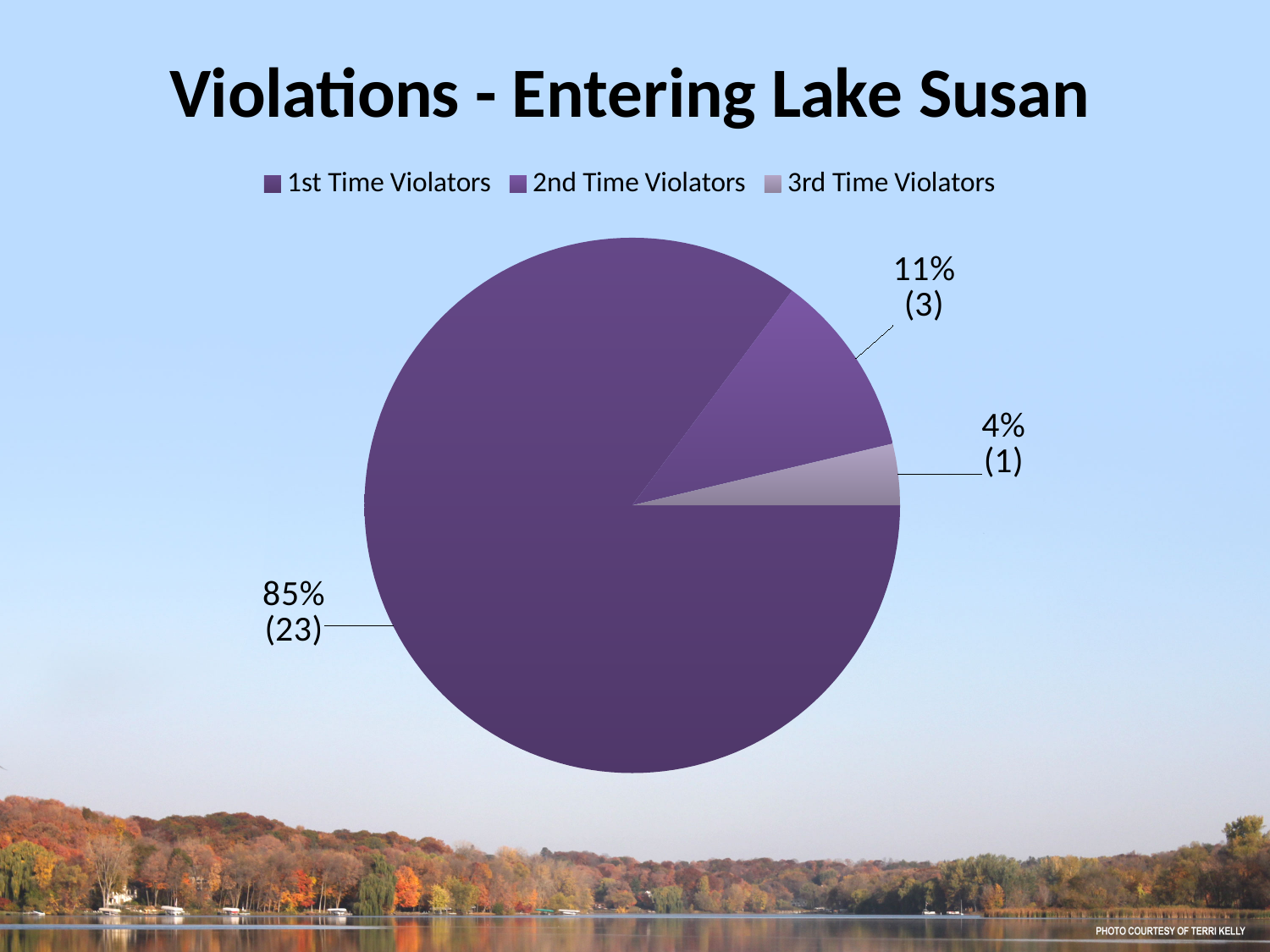
Which category has the smallest share of the pie? 3rd Time Violators What percentage of violations are 2nd Time Violators? 11% Which category has the largest share of the pie? 1st Time Violators How many 2nd Time Violators are shown in the chart? 3 How many more 2nd Time Violators are there than 3rd Time Violators? 2 What is the title of the chart? Violations - Entering Lake Susan How many 3rd Time Violators are shown in the chart? 1 What percentage of violations are 1st Time Violators? 85% What percentage of violations are 3rd Time Violators? 4% How many categories does the legend list? 3 How many 1st Time Violators are shown in the chart? 23 What kind of chart is shown on the slide? pie chart